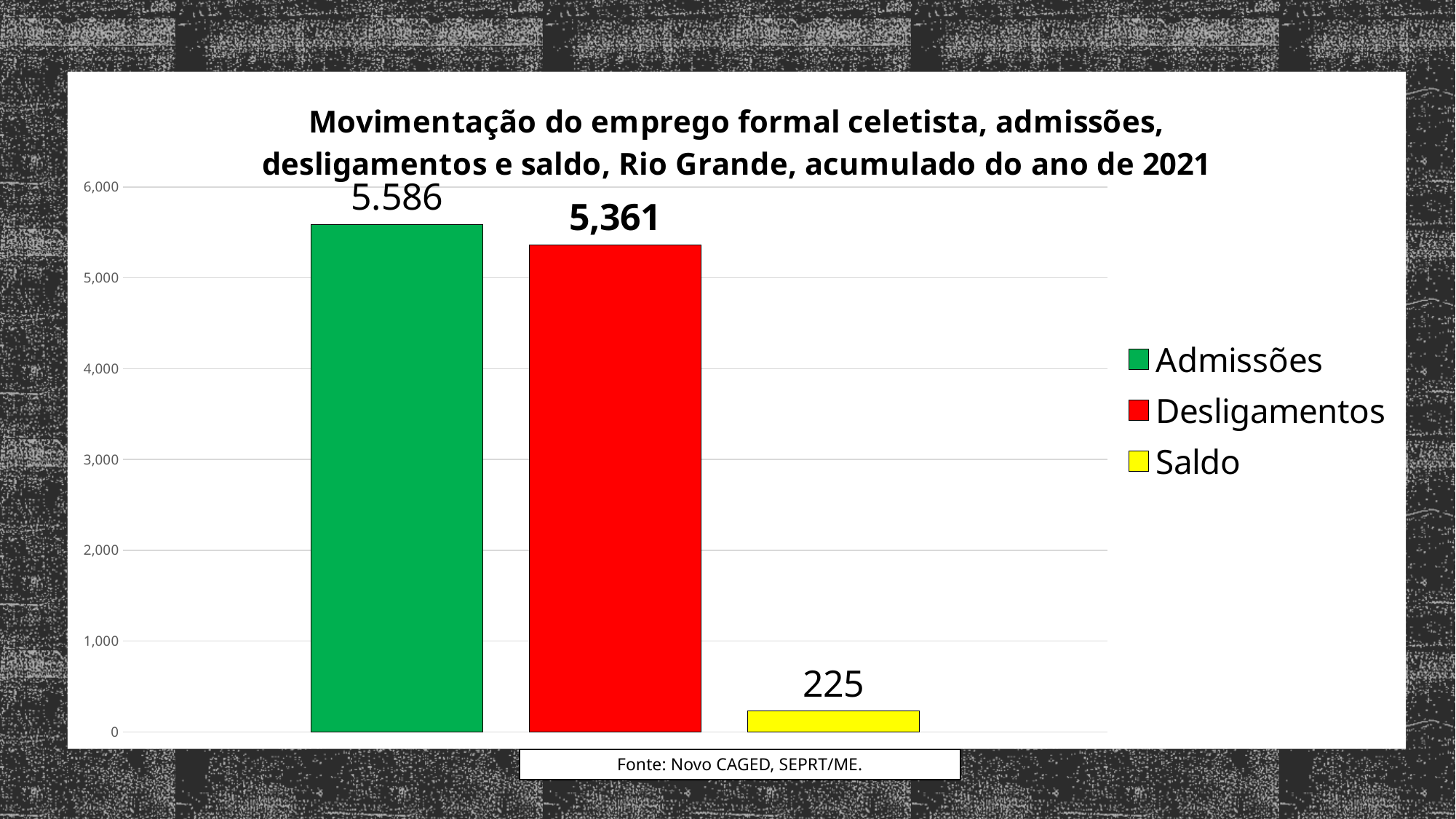
Which series has the highest value? Admissões Is the value for Saldo greater or less than 1,000? less What is the value shown for Admissões? 5.586 What colour is the bar for Saldo? yellow What kind of chart is shown on the slide? bar chart Is the value for Desligamentos greater or less than 5,000? greater What is the difference between the Admissões value and the Desligamentos value? 225 How many series does the legend list? 3 What is the value shown for Desligamentos? 5,361 Which is larger, Admissões or Desligamentos? Admissões What is the value shown for Saldo? 225 Which series has the lowest value? Saldo